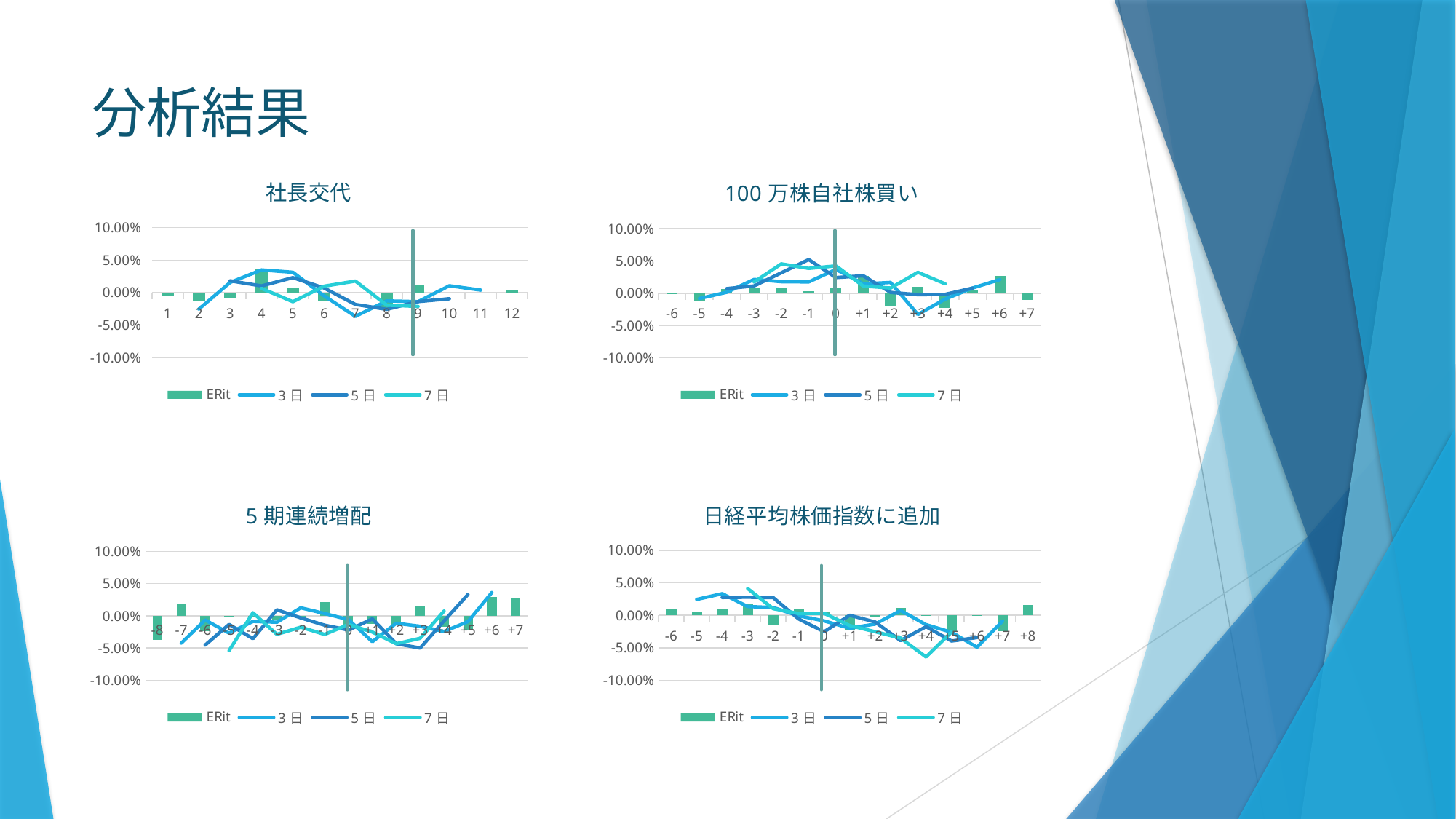
In the 日経平均株価指数に追加 chart, how many categories are on the x axis? 15 How many charts are on the slide? 4 In the 5 期連続増配 chart, at which category is the ERit bar lowest? -8 In the 100 万株自社株買い chart, how many categories are on the x axis? 14 In the 社長交代 chart, at which category is the ERit bar highest? 4 What kind of chart is the 100 万株自社株買い chart? Combination bar and line chart In the 100 万株自社株買い chart, at which category is the ERit bar highest? +6 In the 日経平均株価指数に追加 chart, which series is shown as bars in the legend? ERit In the 社長交代 chart, how many series does the legend list? 4 In the 社長交代 chart, is the ERit value at category 4 greater or less than 5.00%? less